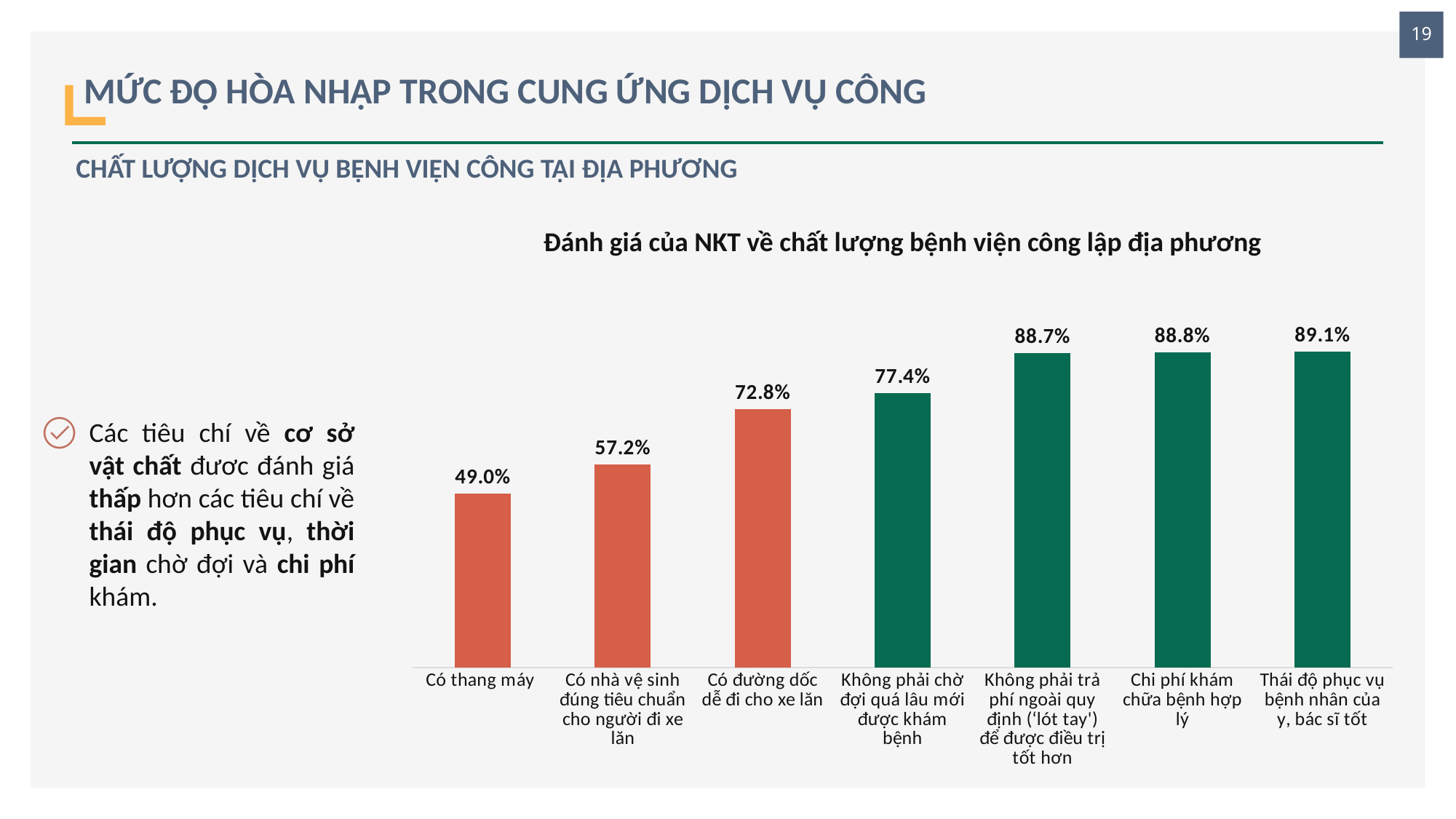
What is the title of the chart? Đánh giá của NKT về chất lượng bệnh viện công lập địa phương How many categories are shown in the chart? 7 What is the value for "Có đường dốc dễ đi cho xe lăn"? 72.8% How many bars are coloured orange-red in the chart? 3 Which category has the lowest value? Có thang máy What kind of chart is shown on the slide? Bar chart What is the value for "Không phải chờ đợi quá lâu mới được khám bệnh"? 77.4% Do the values rise or fall from left to right across the categories? Rise What is the value for "Chi phí khám chữa bệnh hợp lý"? 88.8% What is the difference between the values for "Có nhà vệ sinh đúng tiêu chuẩn cho người đi xe lăn" and "Có thang máy"? 8.2% What is the value for "Có thang máy"? 49.0% Which is larger: the value for "Có đường dốc dễ đi cho xe lăn" or the value for "Không phải chờ đợi quá lâu mới được khám bệnh"? Không phải chờ đợi quá lâu mới được khám bệnh